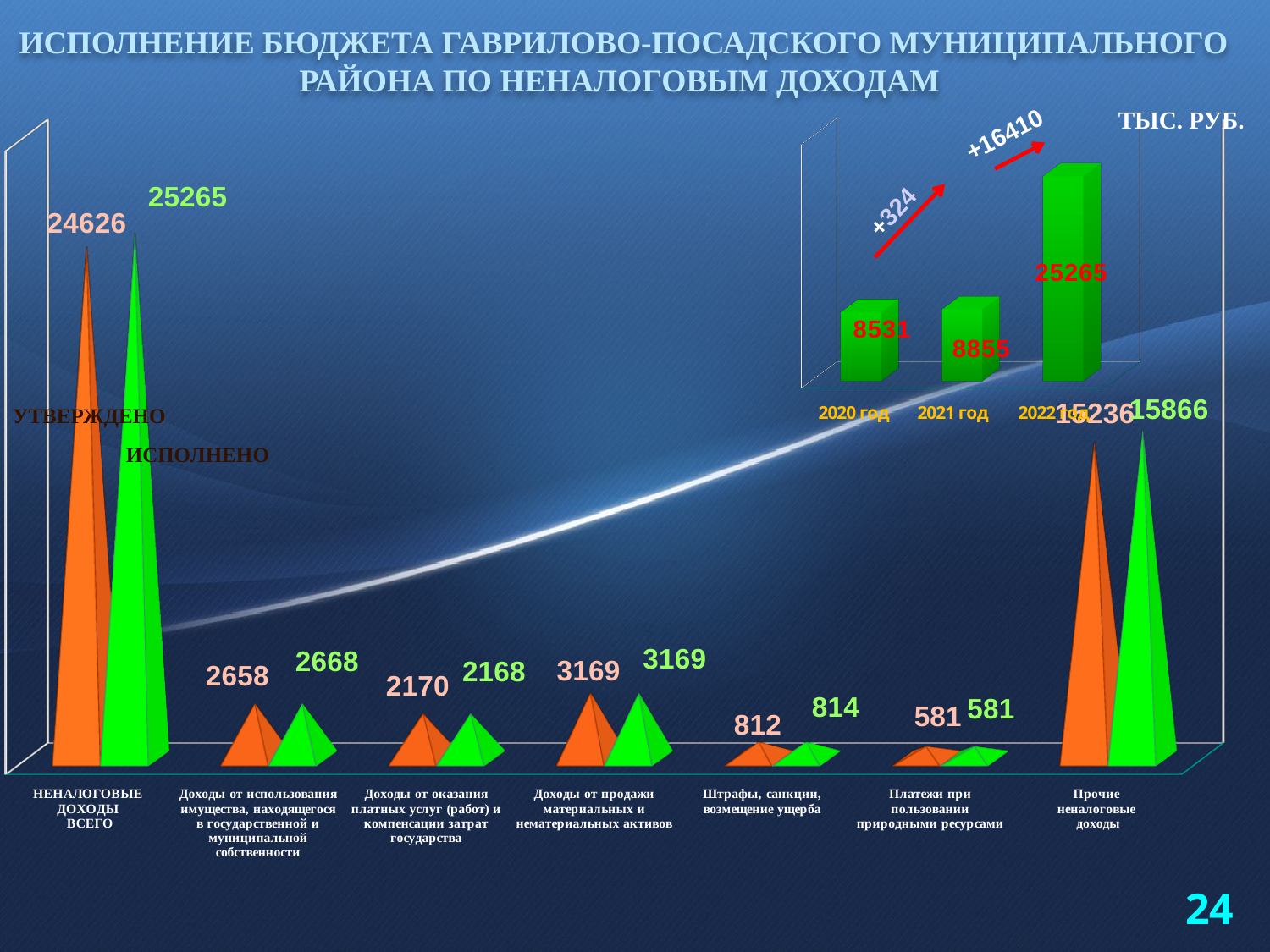
How many series does the main chart show (УТВЕРЖДЕНО and ИСПОЛНЕНО)? 2 How many categories are shown along the bottom of the main chart? 7 On the main chart, which category (excluding the total) has the lowest ИСПОЛНЕНО value? Платежи при пользовании природными ресурсами On the inset chart in the top right, what is the difference between the 2022 and 2021 values? 16410 On the main chart, what is the ИСПОЛНЕНО value for Штрафы, санкции, возмещение ущерба? 814 On the main chart, what is the УТВЕРЖДЕНО (approved) value for Прочие неналоговые доходы? 15236 On the inset chart in the top right, which year has the highest value? 2022 год On the inset chart in the top right, what is the value for 2021 год? 8855 On the inset chart in the top right, do the values rise or fall from 2020 to 2022? rise On the main chart, which is larger: the УТВЕРЖДЕНО value for Доходы от оказания платных услуг or the УТВЕРЖДЕНО value for Доходы от продажи материальных и нематериальных активов? Доходы от продажи материальных и нематериальных активов On the main chart, what is the ИСПОЛНЕНО (executed) value for НЕНАЛОГОВЫЕ ДОХОДЫ ВСЕГО? 25265 On the main chart, what is the difference between the ИСПОЛНЕНО and УТВЕРЖДЕНО values for Прочие неналоговые доходы? 630